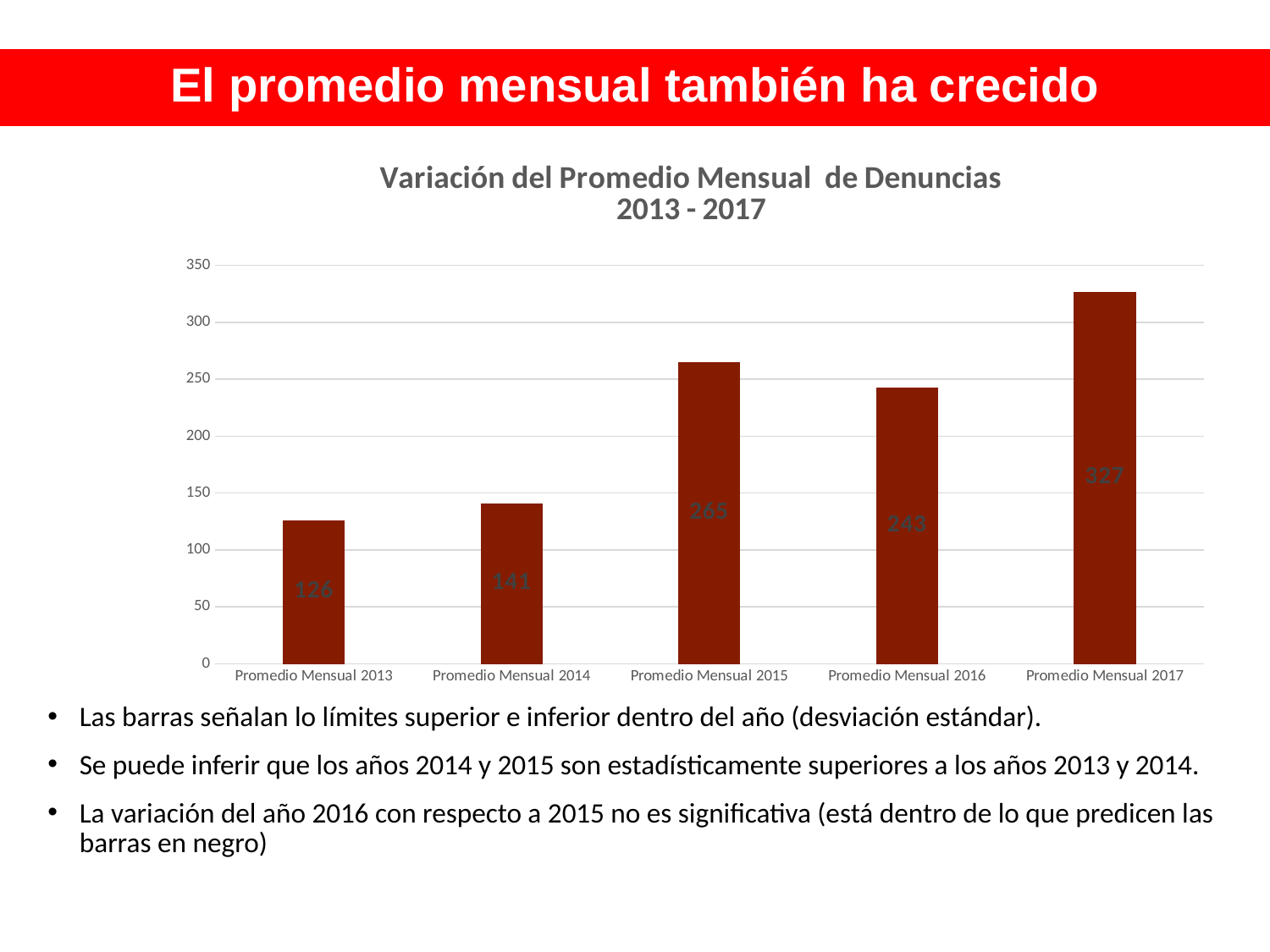
What is the value for Promedio Mensual 2013? 126 What is the value for Promedio Mensual 2015? 265 Which is larger, the value for Promedio Mensual 2015 or Promedio Mensual 2016? Promedio Mensual 2015 What is the value for Promedio Mensual 2017? 327 What is the difference between the values for Promedio Mensual 2015 and Promedio Mensual 2016? 22 Which category has the highest value? Promedio Mensual 2017 What kind of chart is shown on the slide? bar chart What is the difference between the values for Promedio Mensual 2017 and Promedio Mensual 2013? 201 Is the value for Promedio Mensual 2014 greater or less than 150? less Which category has the lowest value? Promedio Mensual 2013 How many categories are shown on the x axis? 5 What is the title of the chart? Variación del Promedio Mensual de Denuncias 2013 - 2017